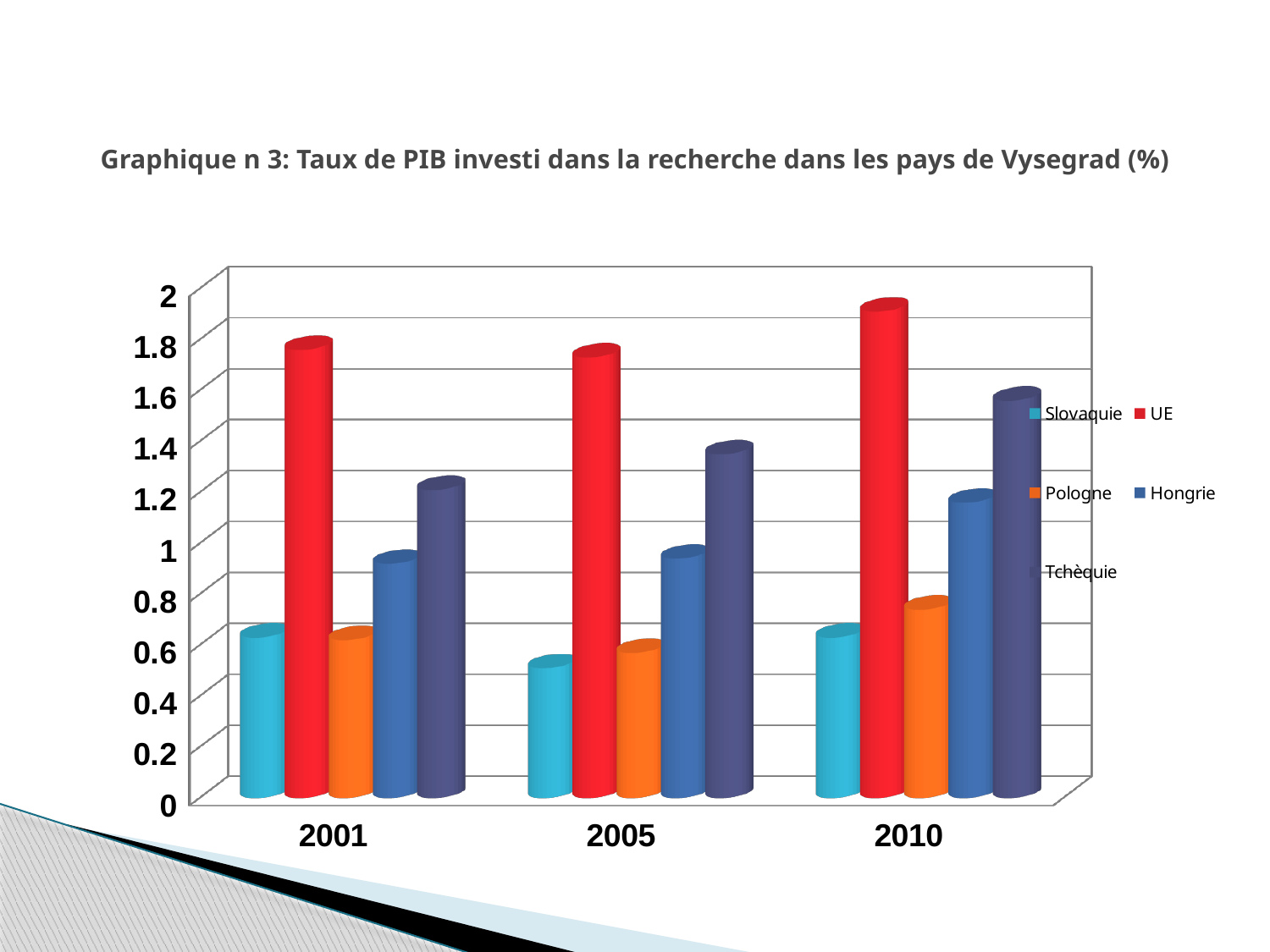
Which series has the highest value in 2010? UE How many years are shown on the x axis of the chart? 3 Which series has the lowest value in 2010? Slovaquie What kind of chart is shown on the slide? bar chart Is the value for Slovaquie in 2005 greater or less than 0.8? less In 2001, which is larger: the value for UE or the value for Tchèquie? UE Does the value for Tchèquie rise or fall from 2001 to 2010? rise How many series does the chart legend list? 5 What colour represents the UE series in the chart? red Is the value for Tchèquie in 2010 greater or less than 1.2? greater In 2005, which is larger: the value for Hongrie or the value for Pologne? Hongrie Is the value for UE in 2010 greater or less than 1.6? greater